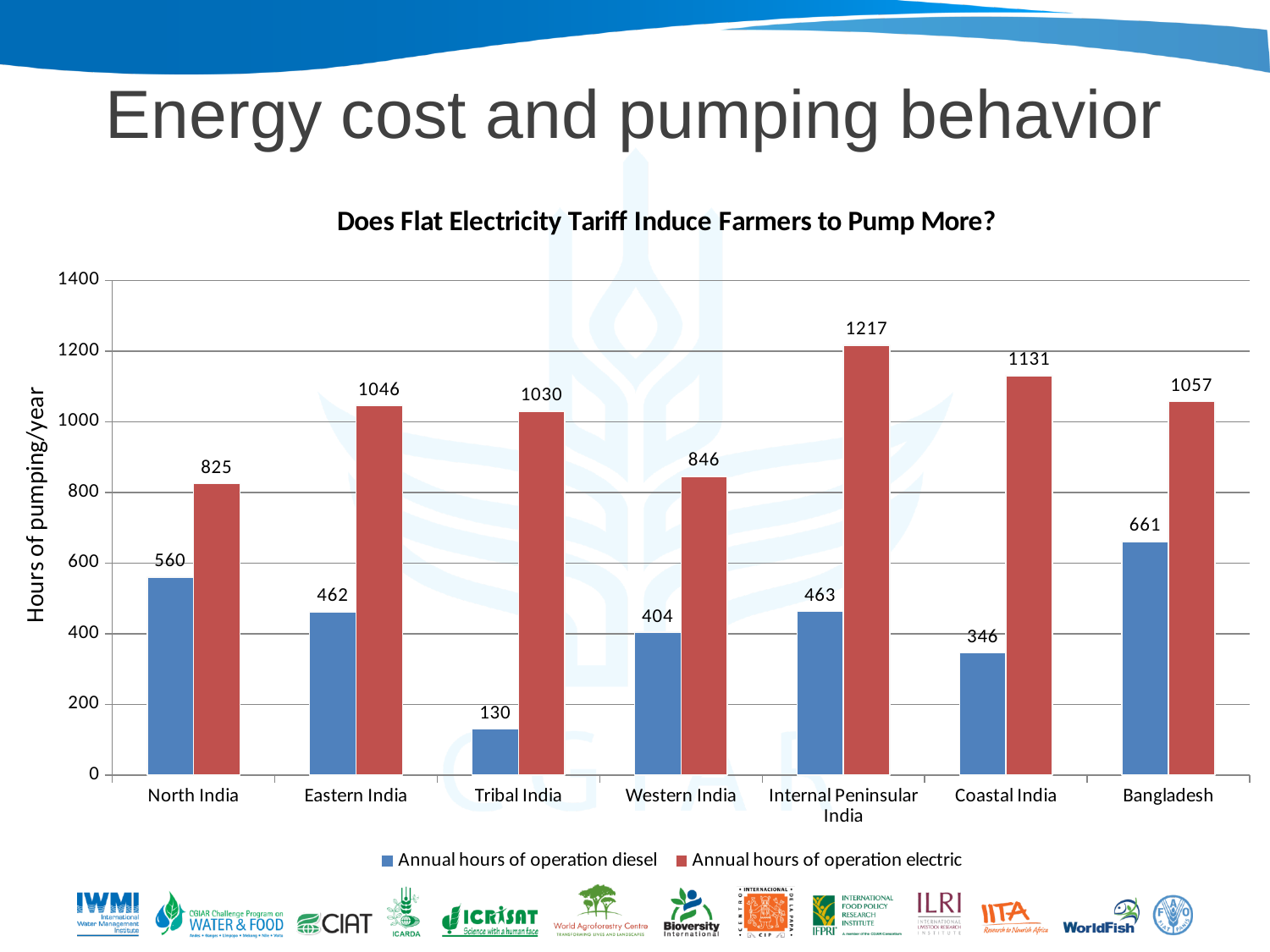
Which region has the highest annual hours of operation for electric pumps? Internal Peninsular India What is the label of the y axis? Hours of pumping/year How many regions are shown on the x axis? 7 What kind of chart is shown on the slide? Bar chart Which region has the lowest annual hours of operation for diesel pumps? Tribal India What is the annual hours of operation for diesel pumps in North India? 560 What is the difference between electric and diesel annual hours of operation in Coastal India? 785 Which is larger: the diesel hours of operation in Bangladesh or in Eastern India? Bangladesh What is the annual hours of operation for electric pumps in Internal Peninsular India? 1217 What is the title of the chart? Does Flat Electricity Tariff Induce Farmers to Pump More? How many series does the legend list? 2 What is the annual hours of operation for diesel pumps in Tribal India? 130